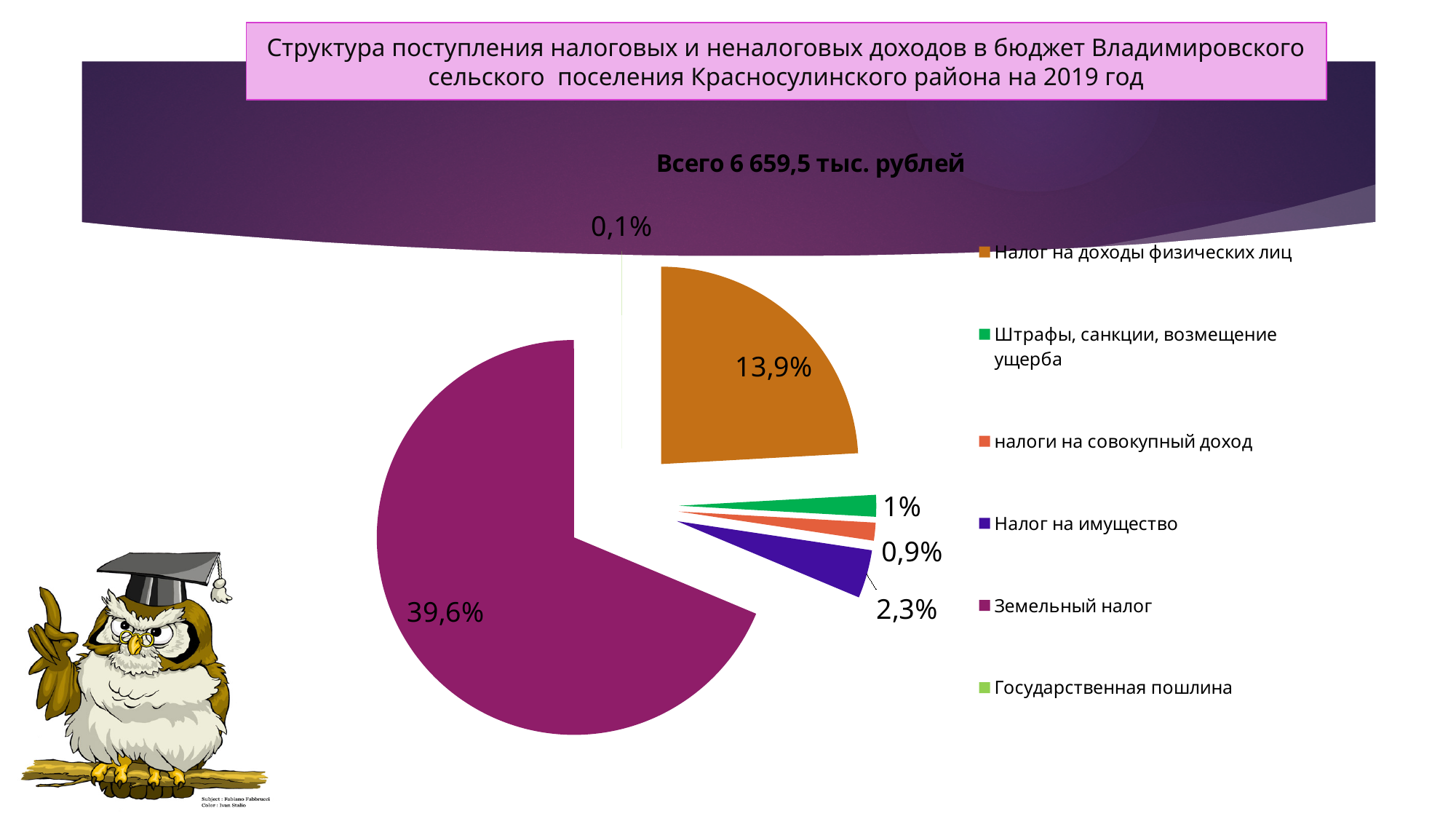
Which category has the smallest slice of the pie? Государственная пошлина How many categories does the legend list? 6 What is the value shown for налоги на совокупный доход? 0,9% What kind of chart is shown on the slide? pie chart What is the value shown for Штрафы, санкции, возмещение ущерба? 1% What is the value shown for Налог на доходы физических лиц? 13,9% What is the value shown for Земельный налог? 39,6% What is the value shown for Налог на имущество? 2,3% What is the value shown for Государственная пошлина? 0,1% Which category has the largest slice of the pie? Земельный налог What total amount is stated above the chart? Всего 6 659,5 тыс. рублей What is the difference between the values for Земельный налог and Налог на доходы физических лиц? 25,7%